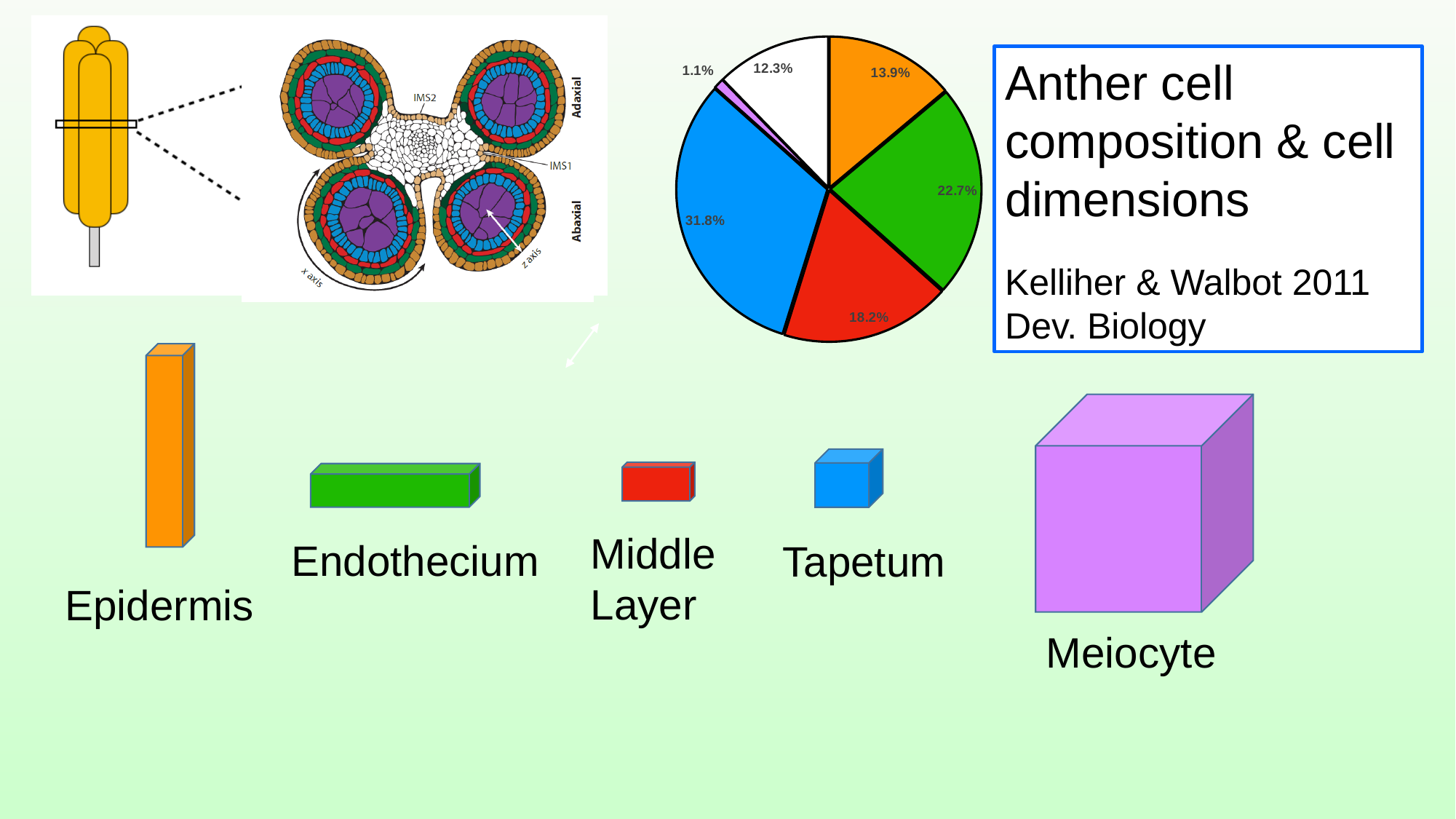
What percentage is shown on the orange slice of the pie chart? 13.9% By how many percentage points does the blue slice exceed the green slice in the pie chart? 9.1 percentage points Which slice of the pie chart has the largest share? The blue slice (31.8%) What is the title shown in the box next to the pie chart? Anther cell composition & cell dimensions Which slice of the pie chart has the smallest share? The purple slice (1.1%) What percentage is shown on the white slice of the pie chart? 12.3% What percentage is shown on the green slice of the pie chart? 22.7% Which slice is larger in the pie chart, the green slice or the red slice? The green slice What percentage is shown on the red slice of the pie chart? 18.2% What kind of chart is shown at the top of the slide? Pie chart How many slices does the pie chart have? 6 What percentage is shown on the blue slice of the pie chart? 31.8%